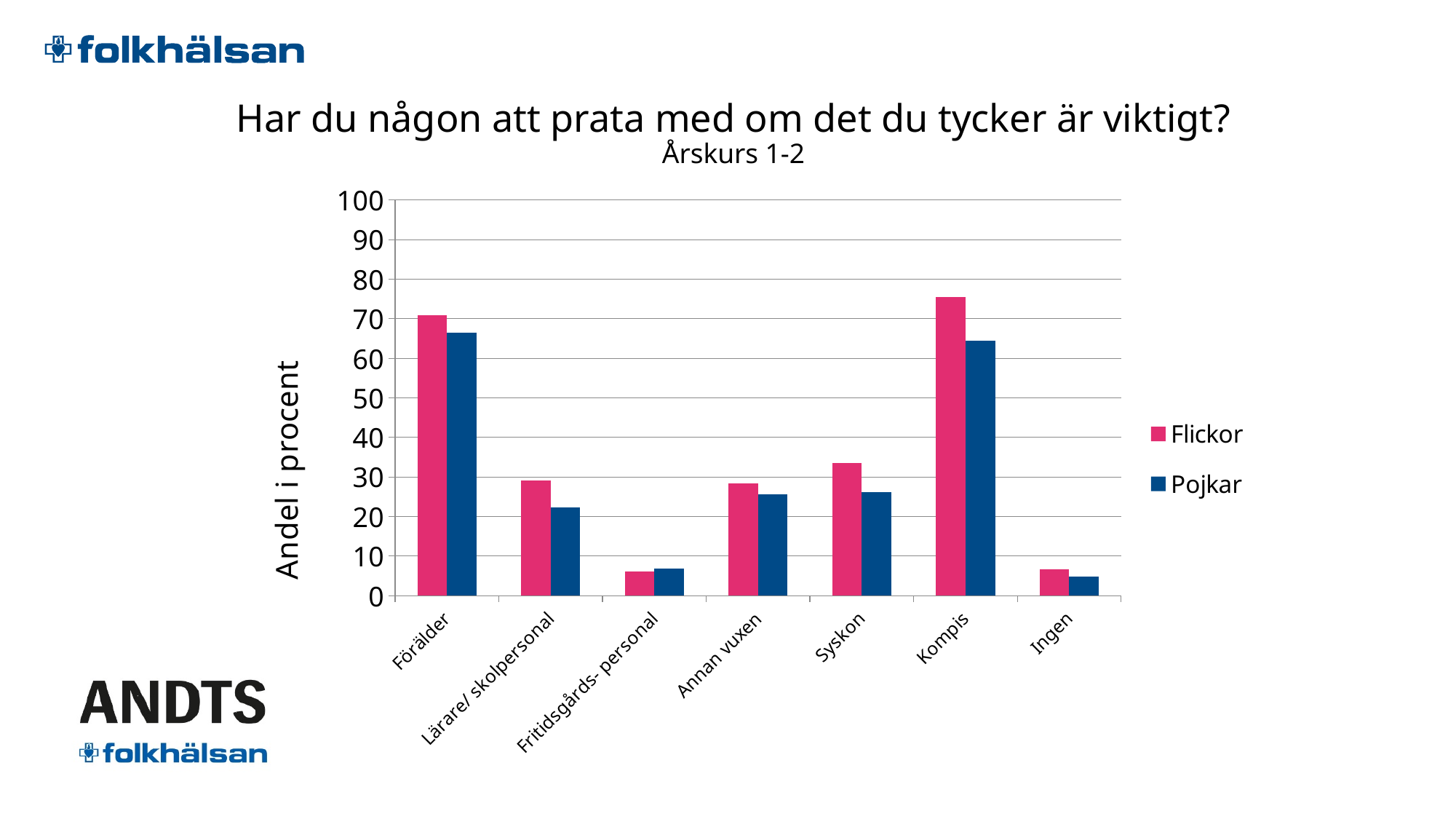
For the Lärare/ skolpersonal category, which series has the larger value, Flickor or Pojkar? Flickor Is the value for Pojkar in the Kompis category greater or less than 70? less Is the value for Flickor in the Ingen category greater or less than 10? less What is the subtitle shown under the chart title? Årskurs 1-2 How many categories are shown on the x axis? 7 Which category has the highest value for Flickor? Kompis Is the value for Flickor in the Syskon category greater or less than 30? greater What is the label of the y axis? Andel i procent What kind of chart is shown on the slide? bar chart For the Kompis category, which series has the larger value, Flickor or Pojkar? Flickor How many series does the legend list? 2